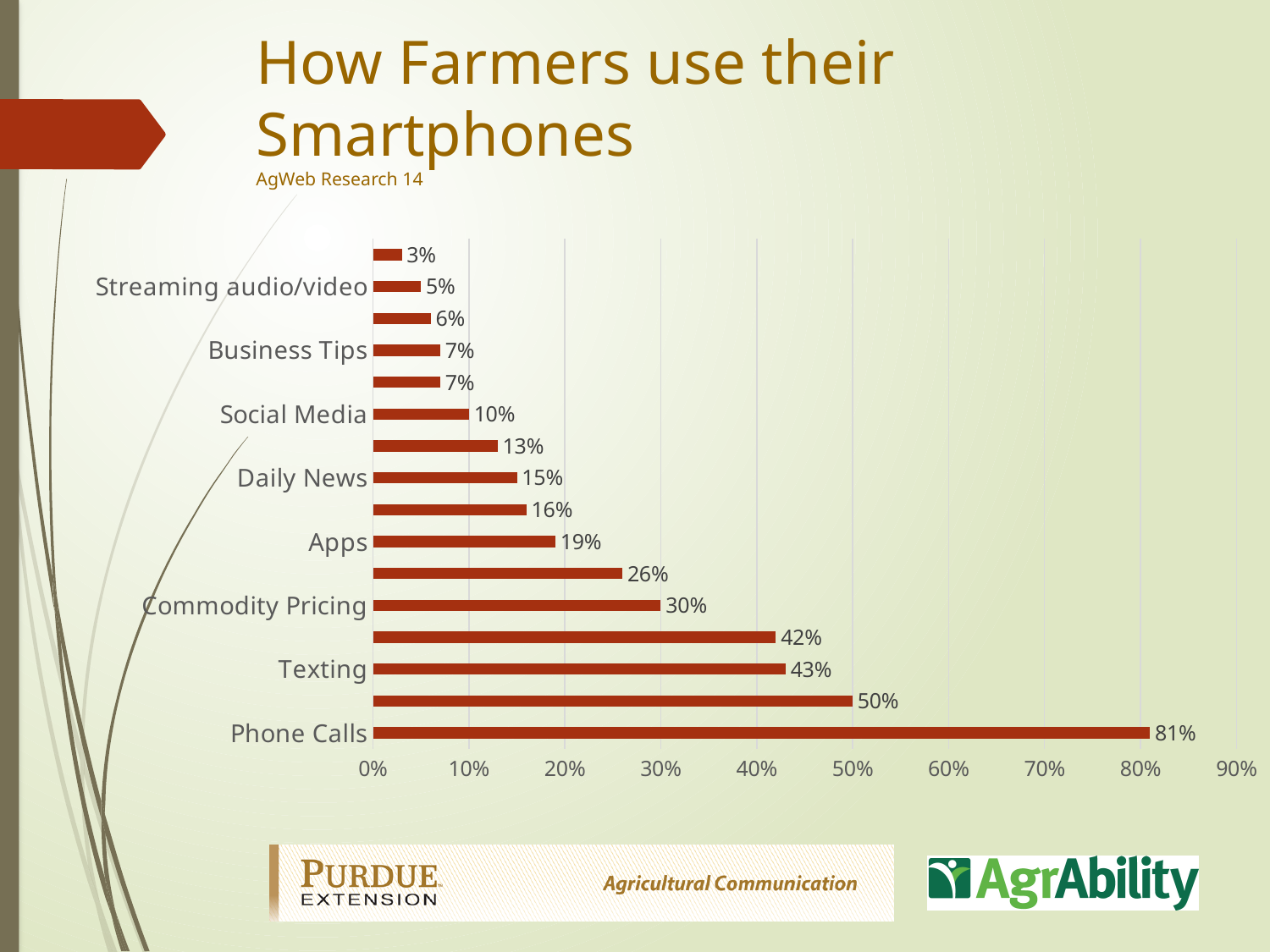
What is the value shown for Streaming audio/video? 5% Is the value for Commodity Pricing greater or less than 20%? greater Which labeled category has the highest value? Phone Calls What is the value shown for Commodity Pricing? 30% What is the value shown for Texting? 43% Which is larger, the value for Apps or the value for Daily News? Apps What is the value shown for Social Media? 10% What is the smallest value printed on any bar in the chart? 3% How many bars are plotted in the chart? 16 What percentage of farmers use their smartphones for Phone Calls? 81% What is the difference between the values for Phone Calls and Texting? 38% What kind of chart is shown on the slide? bar chart